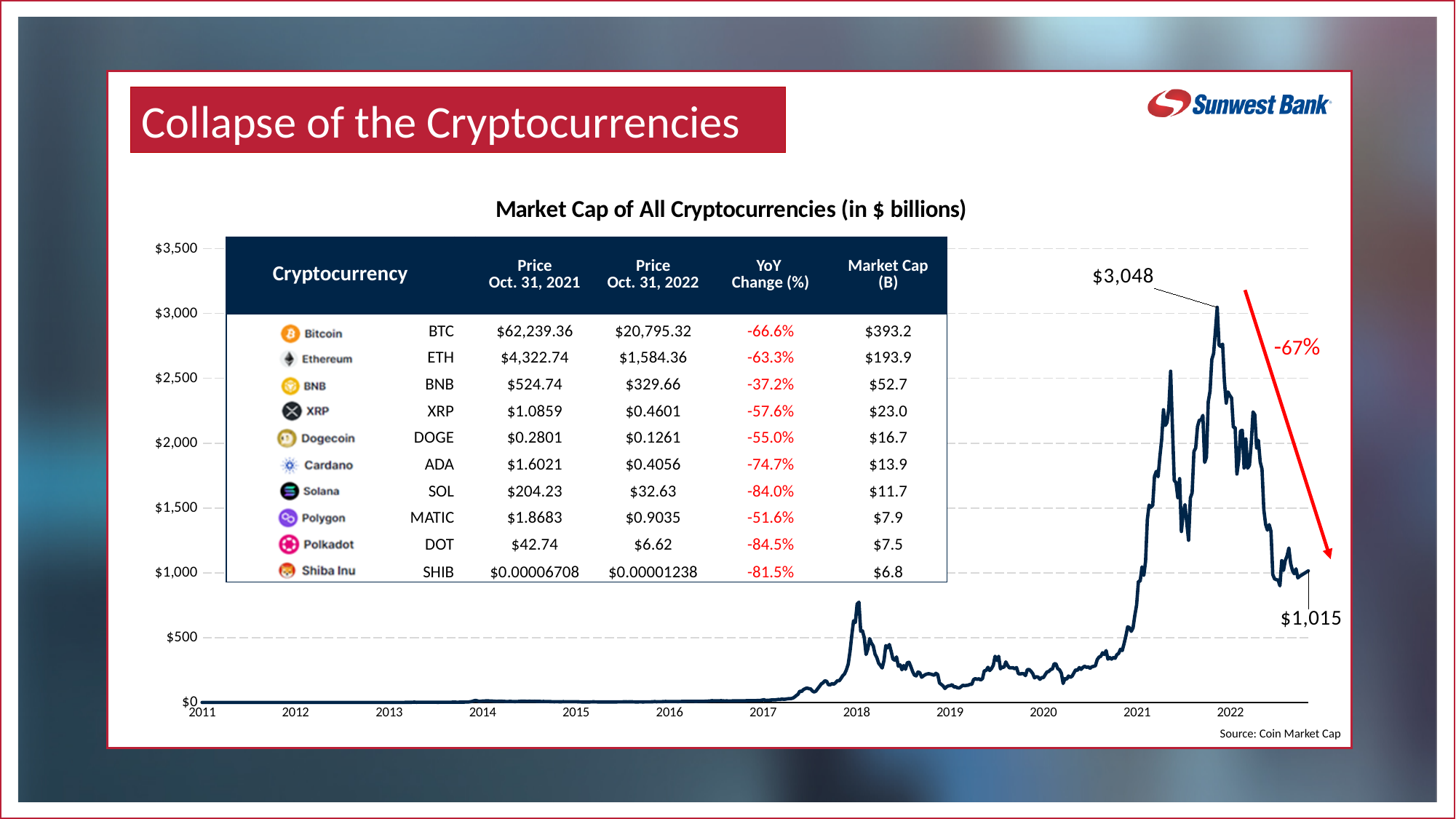
Is the market cap at the early-2018 spike greater or less than $500? greater What is the title of the chart? Market Cap of All Cryptocurrencies (in $ billions) Which of the two labeled values is larger, the peak or the end value? $3,048 Does the market cap line rise or fall from its late-2021 peak to the end of 2022? fall What is the peak value labeled on the market cap line? $3,048 What percentage change is annotated next to the red arrow on the chart? -67% In which year does the market cap line reach its highest point? 2021 Is the market cap during 2019 greater or less than $500? less What is the difference between the labeled peak value and the labeled end value on the chart? $2,033 What kind of chart is shown on the slide? line chart How many year labels are shown on the x axis? 12 What is the most recent value labeled at the end of the market cap line? $1,015